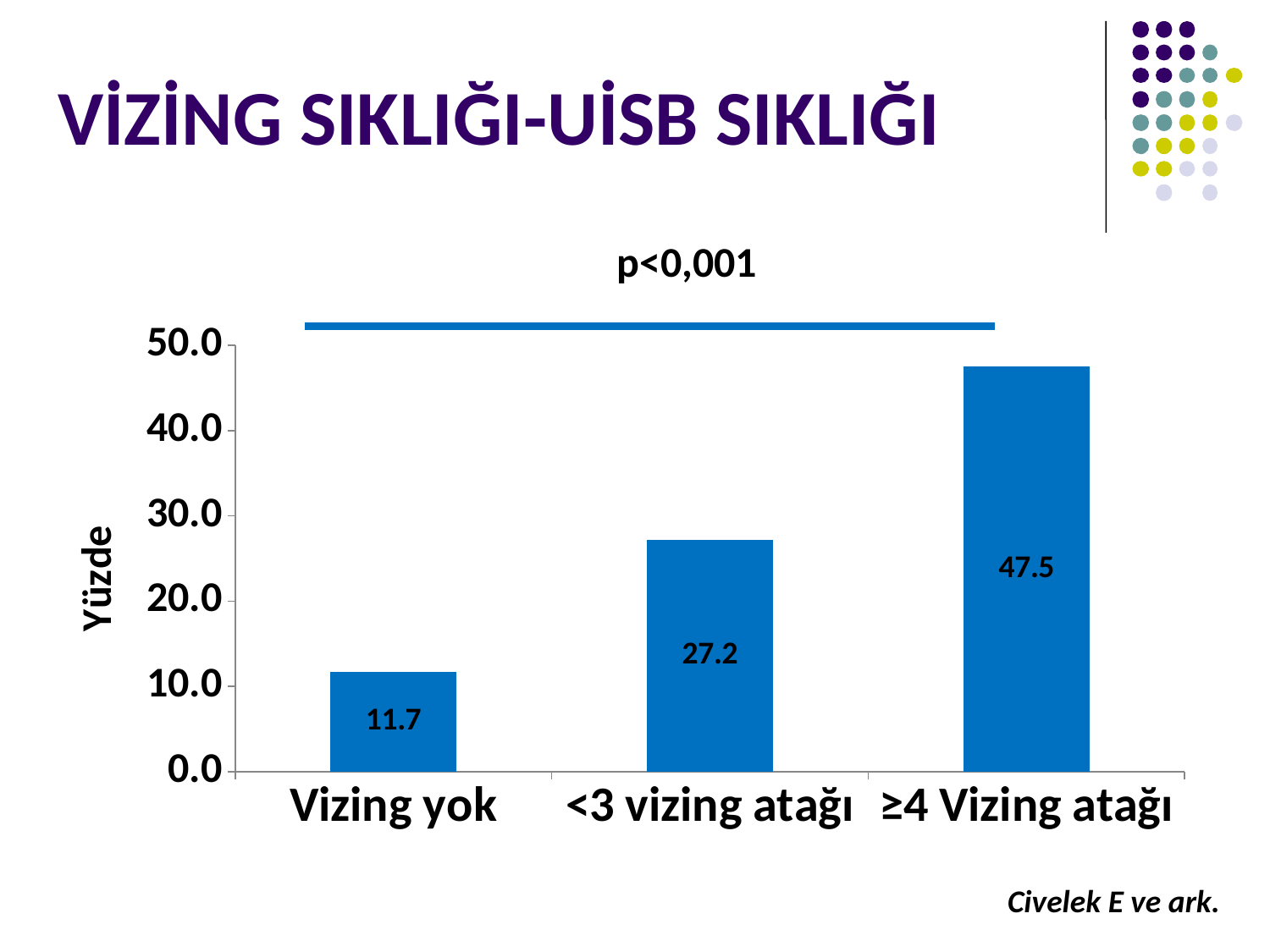
What is the value for "Vizing yok"? 11.7 What is the difference between the values for "<3 vizing atağı" and "Vizing yok"? 15.5 How many categories are shown on the x axis? 3 Which category has the lowest value? Vizing yok What is the difference between the values for "≥4 Vizing atağı" and "Vizing yok"? 35.8 What kind of chart is shown on the slide? bar chart Is the value for "<3 vizing atağı" greater or less than 30.0? less Which is larger, the value for "<3 vizing atağı" or the value for "≥4 Vizing atağı"? ≥4 Vizing atağı What is the value for "≥4 Vizing atağı"? 47.5 Which category has the highest value? ≥4 Vizing atağı What is the value for "<3 vizing atağı"? 27.2 Do the values rise or fall from left to right along the x axis? rise